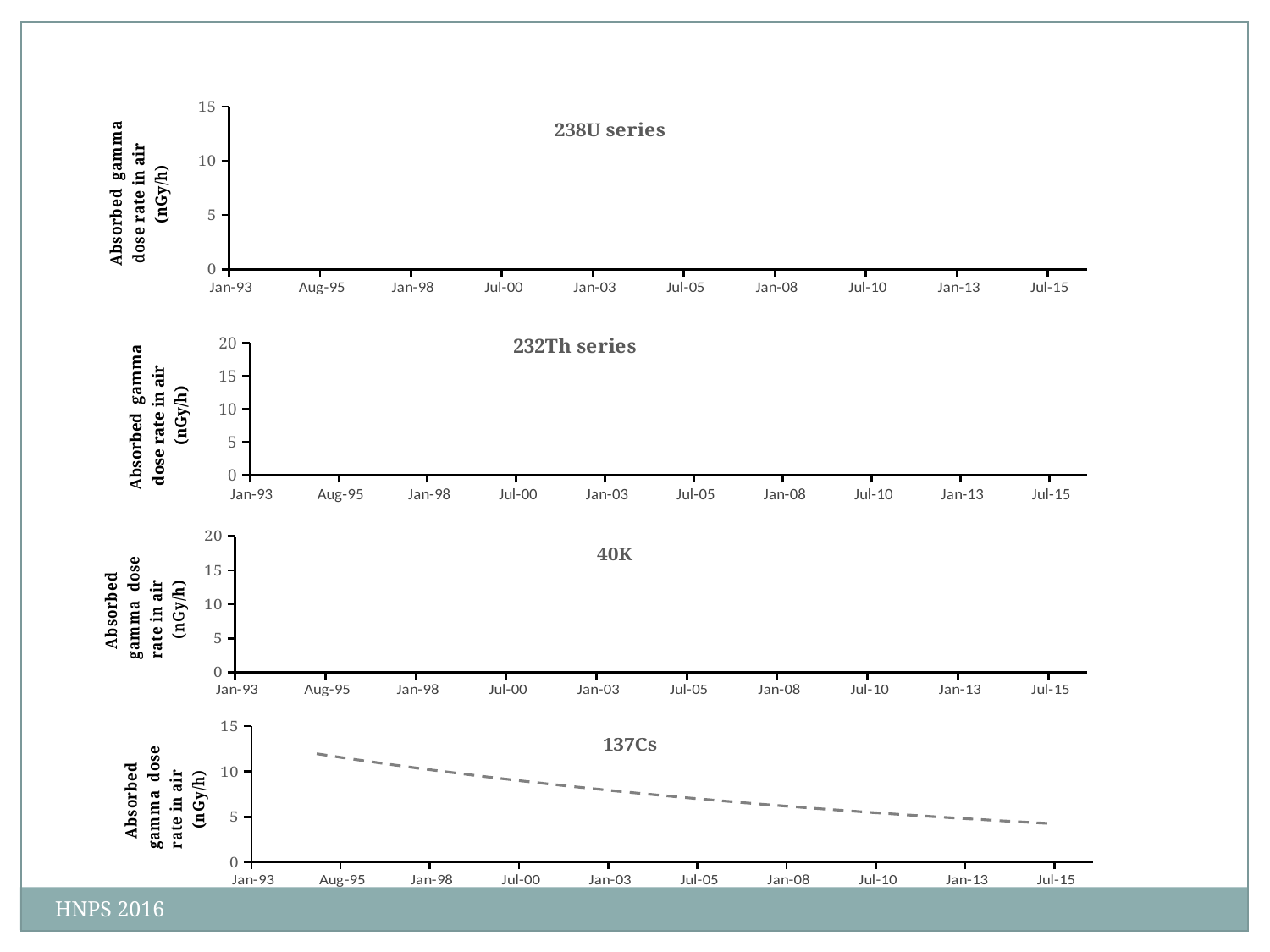
In the 137Cs chart, is the value at Jan-03 greater or less than 10? less In the 137Cs chart, do the values rise or fall from Aug-95 to Jul-15? fall In the 137Cs chart, which is larger, the value at Aug-95 or the value at Jul-15? Aug-95 In the 137Cs chart, at which x-axis date is the plotted value lowest? Jul-15 In the 137Cs chart, is the value at Jul-05 greater or less than 5? greater In the 137Cs chart, is the value at Jul-15 greater or less than 5? less What is the title of the topmost chart on the slide? 238U series What kind of chart is the 137Cs chart at the bottom of the slide? line chart In the 137Cs chart, at which x-axis date is the plotted value highest? Aug-95 What is the maximum value shown on the y-axis of the 232Th series chart? 20